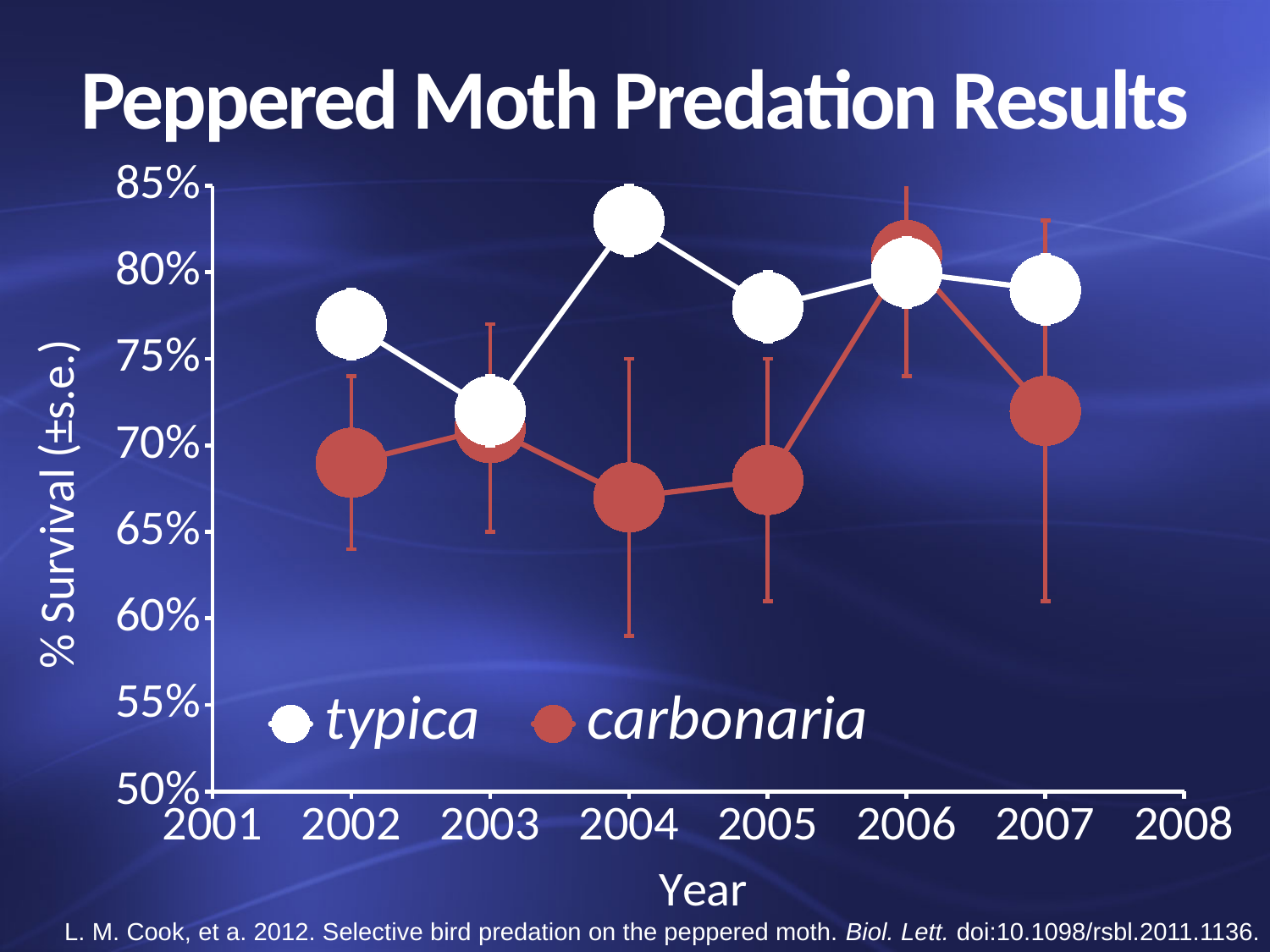
How many series does the legend list? 2 In 2004, which series has the higher survival, typica or carbonaria? typica What are the two series named in the legend? typica and carbonaria Is the carbonaria survival value for 2004 greater or less than 70%? less In which year is the carbonaria survival highest? 2006 What kind of chart is shown on the slide? line chart Does the carbonaria survival rise or fall from 2005 to 2006? rise In which year is the typica survival lowest? 2003 How many years have data points plotted for the typica series? 6 Is the typica survival value for 2003 greater or less than 75%? less In which year is the typica survival highest? 2004 Is the typica survival value for 2004 greater or less than 80%? greater